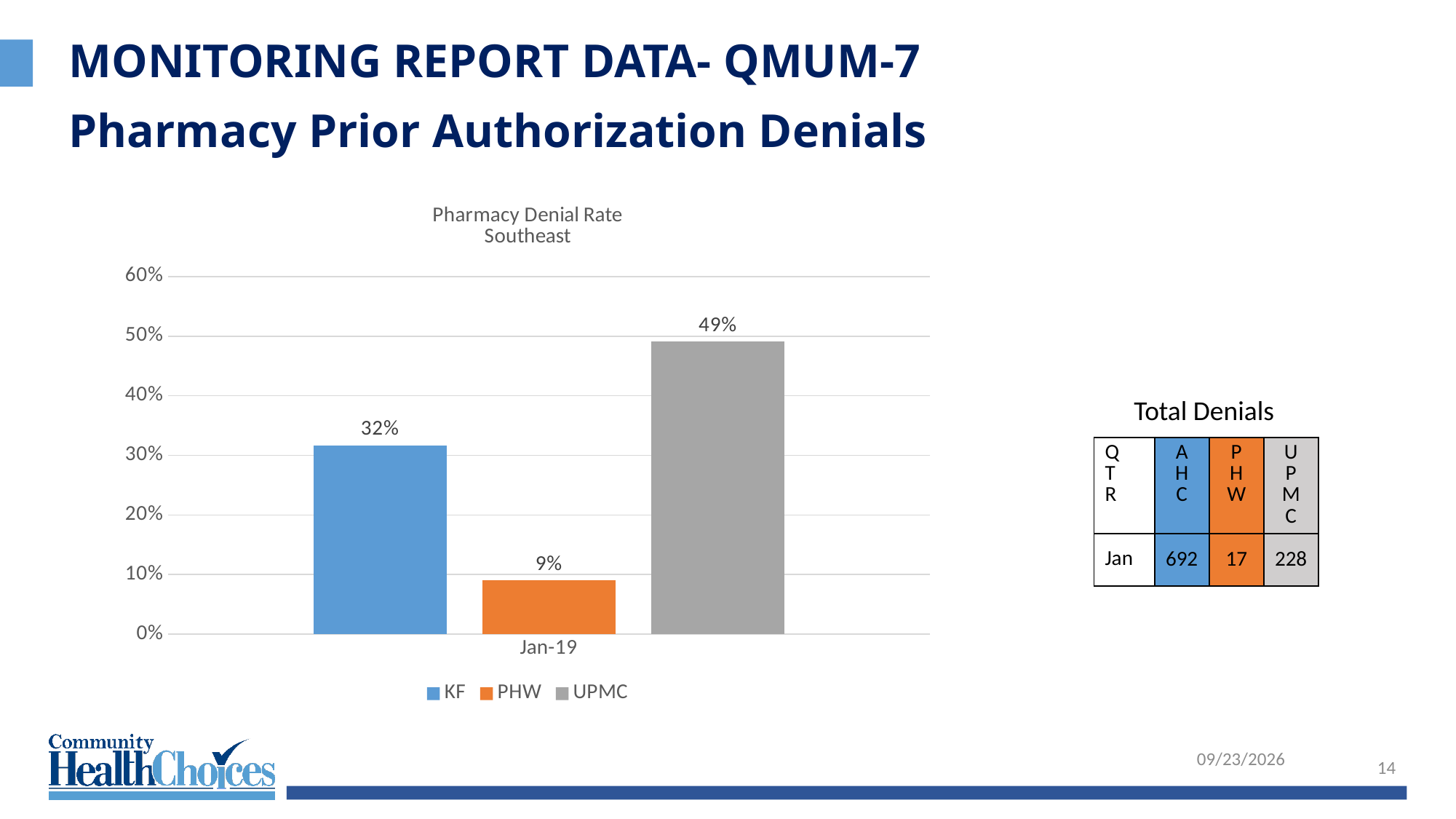
What is the pharmacy denial rate for KF in Jan-19? 32% Which series has the lowest pharmacy denial rate? PHW How many series does the legend list? 3 Is the value for UPMC greater or less than 40%? greater What is the difference between the UPMC and KF denial rates? 17% What kind of chart is shown on the slide? Bar chart What is the title of the chart? Pharmacy Denial Rate Southeast Which has a higher denial rate, KF or PHW? KF What is the pharmacy denial rate for UPMC in Jan-19? 49% What is the difference between the KF and PHW denial rates? 23% Which series has the highest pharmacy denial rate? UPMC What is the pharmacy denial rate for PHW in Jan-19? 9%